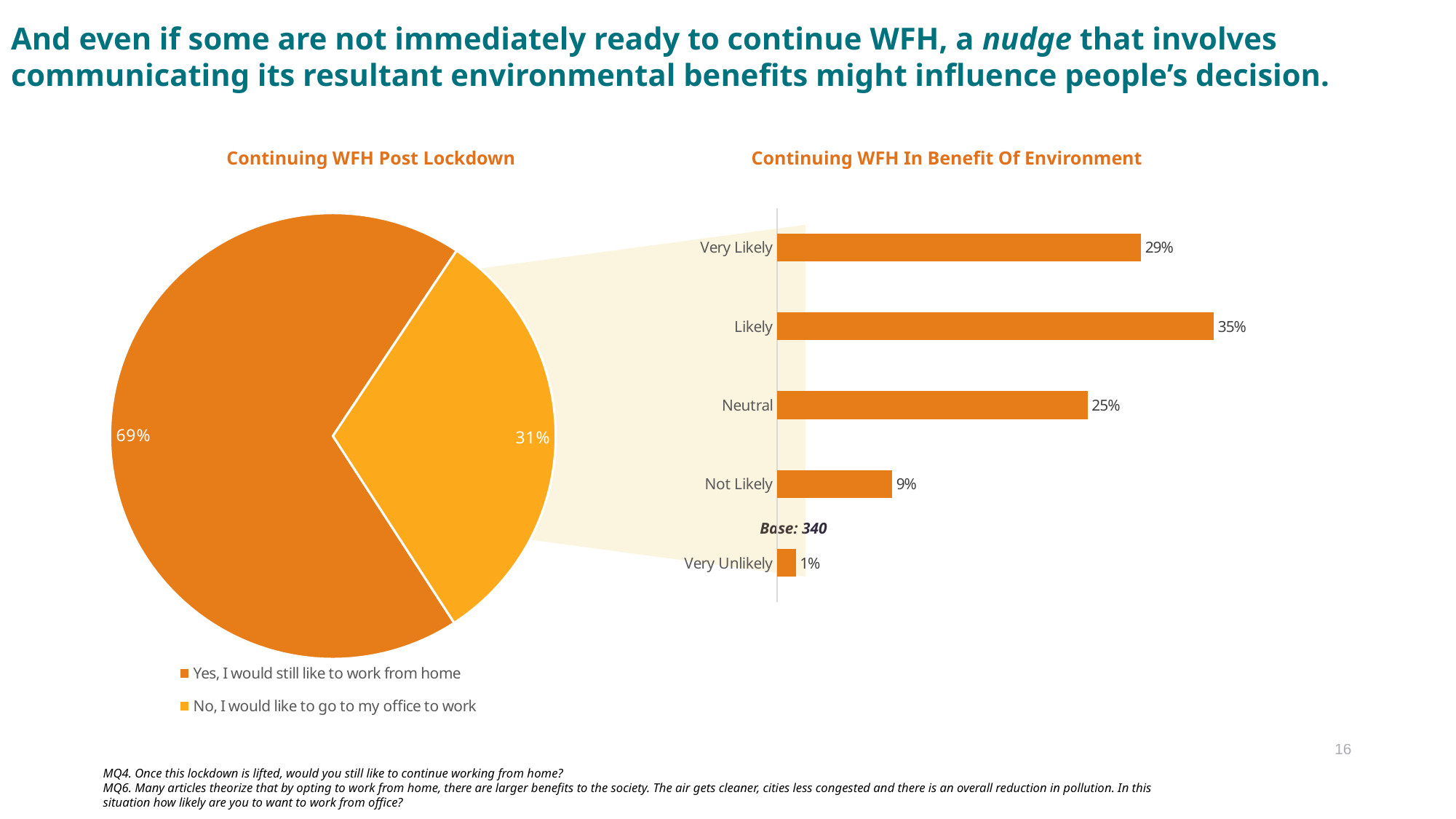
In the 'Continuing WFH Post Lockdown' chart, what share of respondents said 'No, I would like to go to my office to work'? 31% What kind of chart is 'Continuing WFH In Benefit Of Environment'? Bar chart In the 'Continuing WFH In Benefit Of Environment' chart, which category has the lowest value? Very Unlikely What kind of chart is 'Continuing WFH Post Lockdown'? Pie chart In the 'Continuing WFH In Benefit Of Environment' chart, what is the difference between 'Very Likely' and 'Neutral'? 4% In the 'Continuing WFH In Benefit Of Environment' chart, what is the value for 'Not Likely'? 9% In the 'Continuing WFH Post Lockdown' chart, what share of respondents said 'Yes, I would still like to work from home'? 69% In the 'Continuing WFH In Benefit Of Environment' chart, which category has the highest value? Likely How many categories are shown in the 'Continuing WFH In Benefit Of Environment' chart? 5 In the 'Continuing WFH In Benefit Of Environment' chart, which is larger, 'Very Likely' or 'Neutral'? Very Likely How many entries does the legend of the 'Continuing WFH Post Lockdown' chart list? 2 In the 'Continuing WFH In Benefit Of Environment' chart, what is the value for 'Likely'? 35%